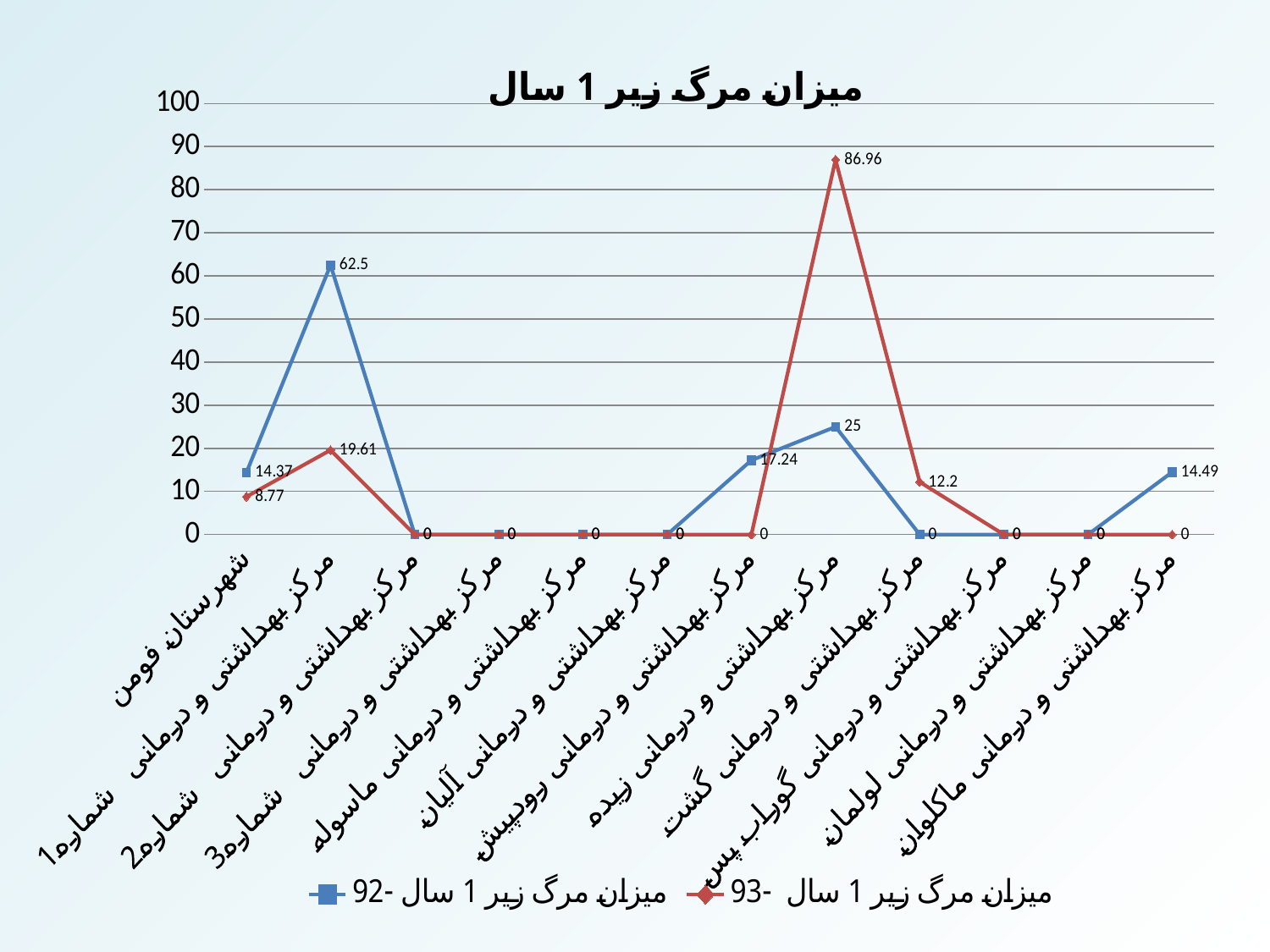
How many categories are shown on the x axis? 12 For شهرستان فومن, which series has the larger value, 92 (blue) or 93 (red)? 92 (blue) What is the value of the 92 series (blue) for مرکز بهداشتی و درمانی شماره1? 62.5 How many series does the legend list? 2 What is the difference between the 93 series and the 92 series values for مرکز بهداشتی و درمانی زیده? 61.96 Which category has the highest value in the 93 series (red)? مرکز بهداشتی و درمانی زیده What is the value of the 92 series (blue) for شهرستان فومن? 14.37 What is the value of the 93 series (red) for مرکز بهداشتی و درمانی زیده? 86.96 What is the title of the chart? میزان مرگ زیر 1 سال Which category has the highest value in the 92 series (blue)? مرکز بهداشتی و درمانی شماره1 What type of chart is shown on the slide? line chart What is the value of the 93 series (red) for مرکز بهداشتی و درمانی گشت? 12.2